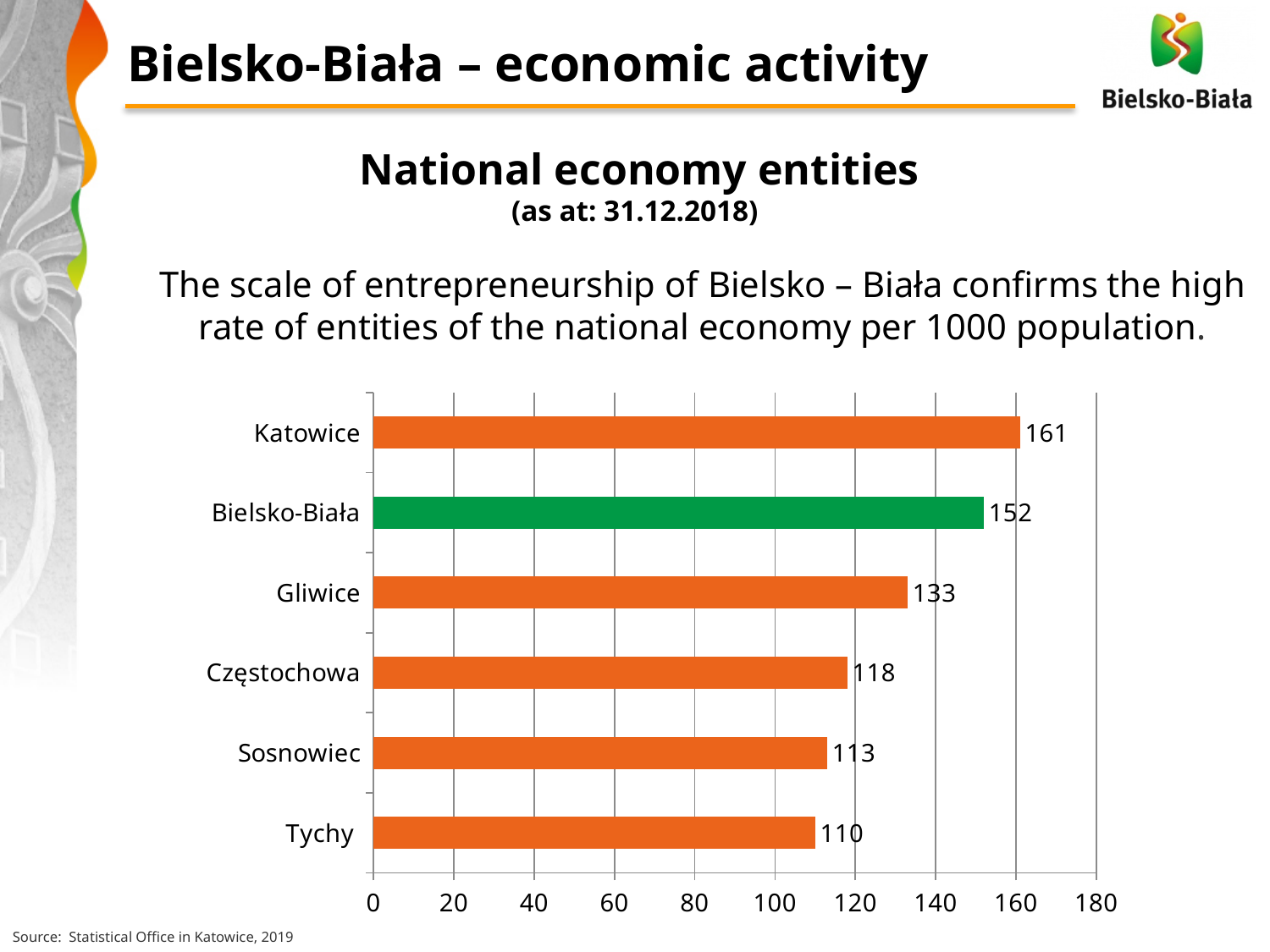
Which city has the lowest value? Tychy What is the value for Częstochowa? 118 How many cities are shown in the chart? 6 What is the value for Katowice? 161 Which city has the highest value? Katowice Which bar is coloured green rather than orange? Bielsko-Biała What is the difference between the values for Gliwice and Tychy? 23 What is the value for Bielsko-Biała? 152 What kind of chart is shown on the slide? bar chart Which is larger, the value for Gliwice or the value for Sosnowiec? Gliwice Is the value for Sosnowiec greater or less than 100? greater What is the difference between the values for Katowice and Bielsko-Biała? 9